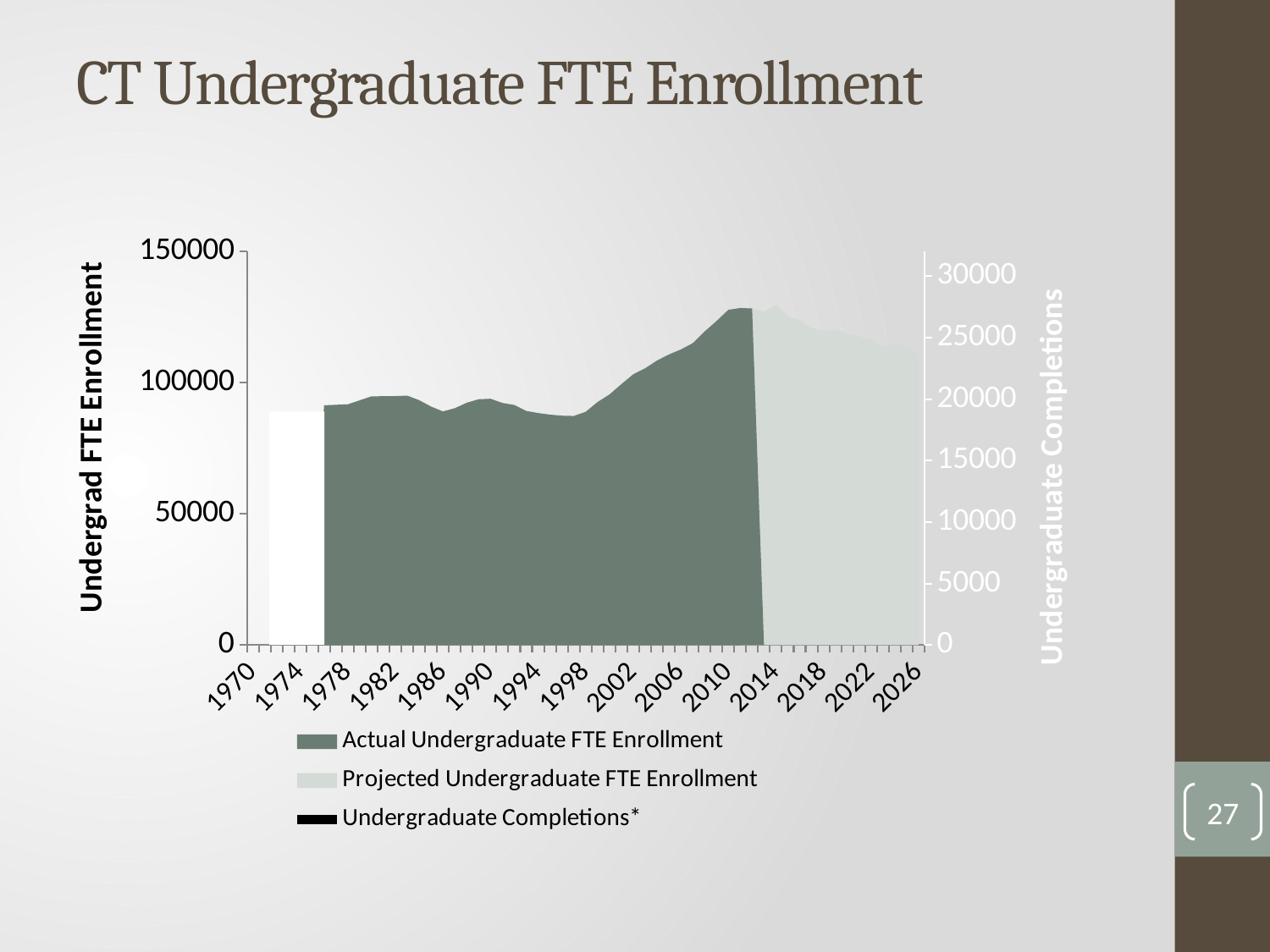
What is the label on the right-hand vertical axis? Undergraduate Completions How many series does the legend list? 3 Is the Actual Undergraduate FTE Enrollment value for 1982 greater or less than 150000? less Is the Actual Undergraduate FTE Enrollment value for 1978 greater or less than 50000? greater Is the Actual Undergraduate FTE Enrollment value for 1998 greater or less than 100000? less Does the Actual Undergraduate FTE Enrollment rise or fall between 1998 and 2012? rise Does the Projected Undergraduate FTE Enrollment rise or fall between 2014 and 2026? fall What is the title of the chart? CT Undergraduate FTE Enrollment Which is larger: the Actual Undergraduate FTE Enrollment in 1978 or in 2012? 2012 What kind of chart is shown on the slide? Area chart